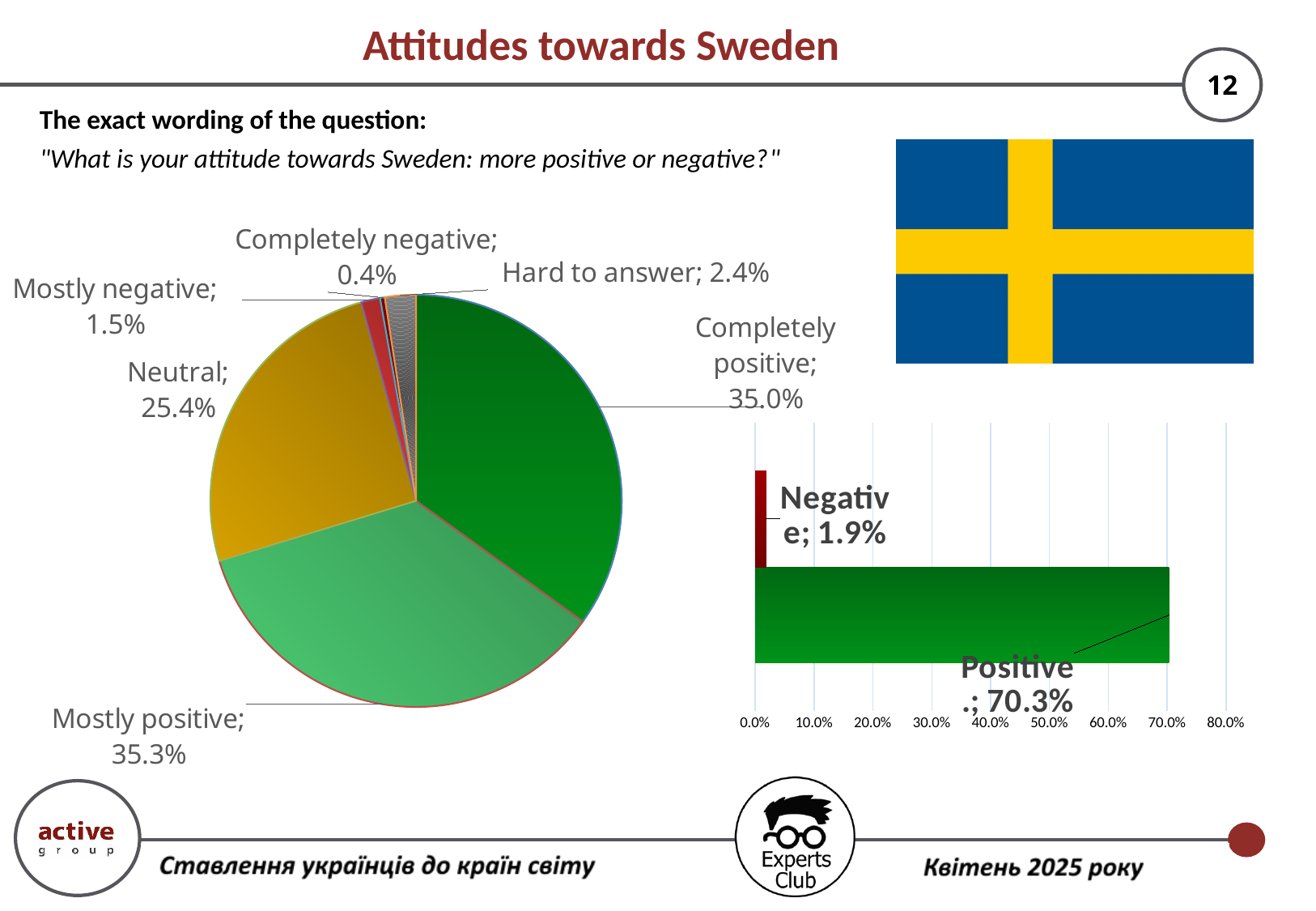
In the pie chart on the left, what share of respondents answered "Completely positive"? 35.0% In the pie chart on the left, what share of respondents answered "Hard to answer"? 2.4% In the bar chart on the right, what is the value for "Negative"? 1.9% In the bar chart on the right, what is the difference between the "Positive" and "Negative" values? 68.4% In the pie chart on the left, which category has the smallest share? Completely negative In the pie chart on the left, what is the difference between the "Neutral" share and the "Mostly negative" share? 23.9% In the pie chart on the left, which is larger: "Mostly negative" or "Hard to answer"? Hard to answer In the pie chart on the left, which category has the largest share? Mostly positive In the bar chart on the right, what is the value for "Positive"? 70.3% In the pie chart on the left, how many categories are shown? 6 What type of chart is shown on the right side of the slide? Bar chart In the pie chart on the left, what share of respondents answered "Neutral"? 25.4%